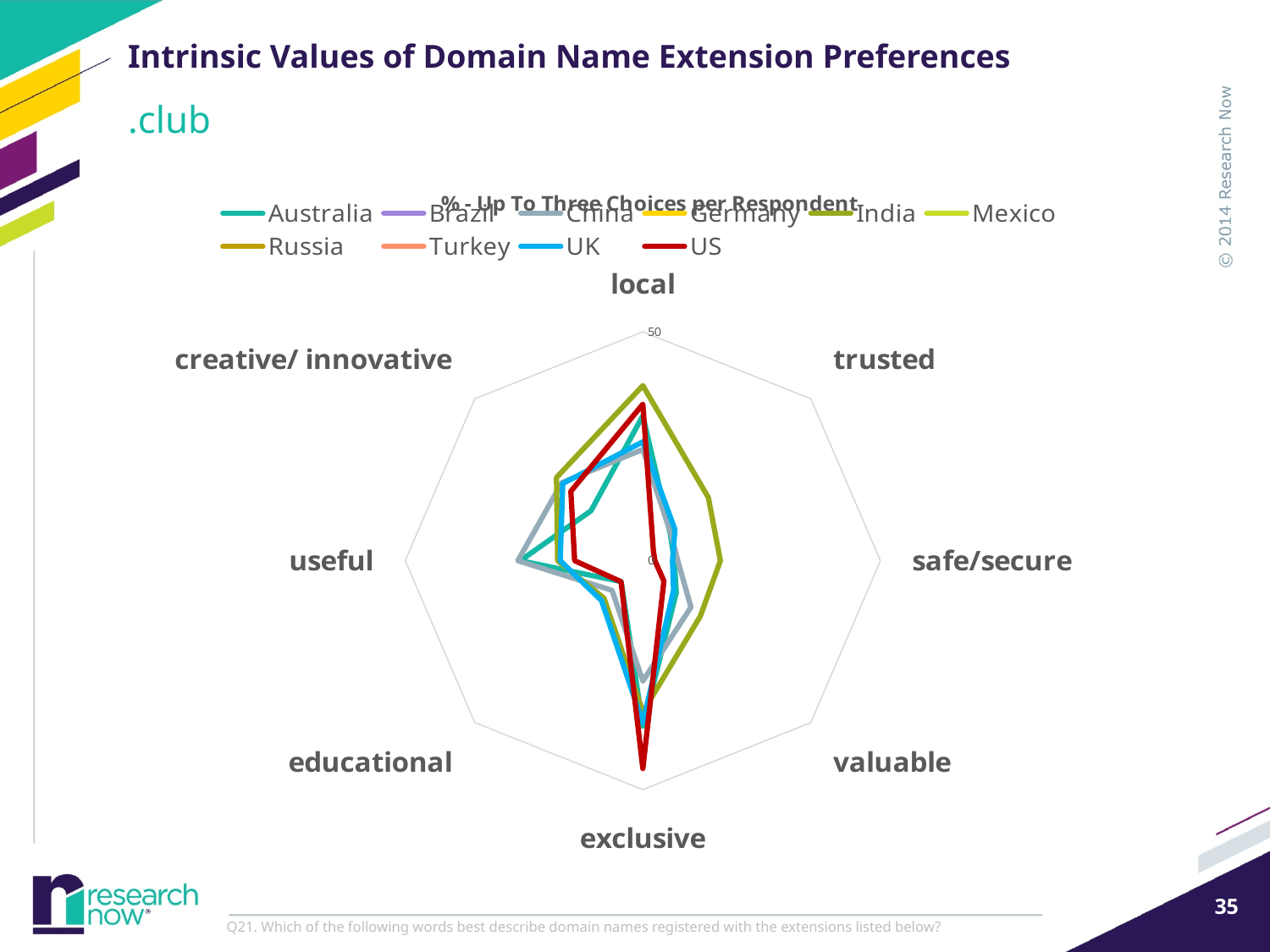
How many categories (axes) does the radar chart have? 8 Is the value for US on local greater or less than 25? greater Is the value for US on valuable greater or less than 25? less What is the maximum value shown on the chart's axis scale? 50 Is the value for US on trusted greater or less than 25? less Which category is at the top of the radar chart? local What kind of chart is shown on the slide? radar chart How many series does the legend list? 10 For which category does the US line reach its highest value? exclusive What is the title of the chart? % - Up To Three Choices per Respondent